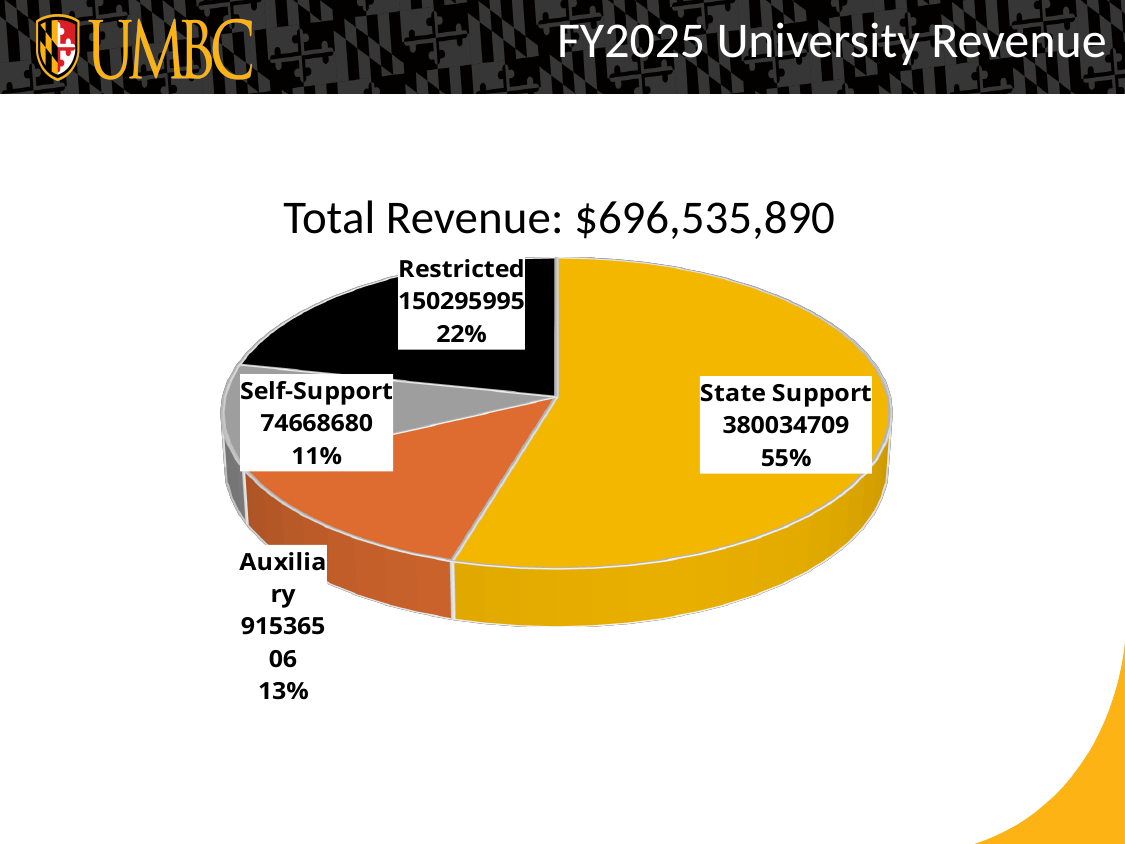
What percentage share of the pie is Auxiliary? 13% What percentage share of the pie is State Support? 55% Which category has the largest slice? State Support What is the difference between the State Support value and the Restricted value? 229738714 What is the value shown for Restricted? 150295995 What is the value shown for Self-Support? 74668680 What is the title of the chart? Total Revenue: $696,535,890 Which is larger, the Restricted value or the Auxiliary value? Restricted Which category has the smallest slice? Self-Support What type of chart is shown on the slide? Pie chart What is the value shown for State Support? 380034709 How many slices does the pie chart have? 4